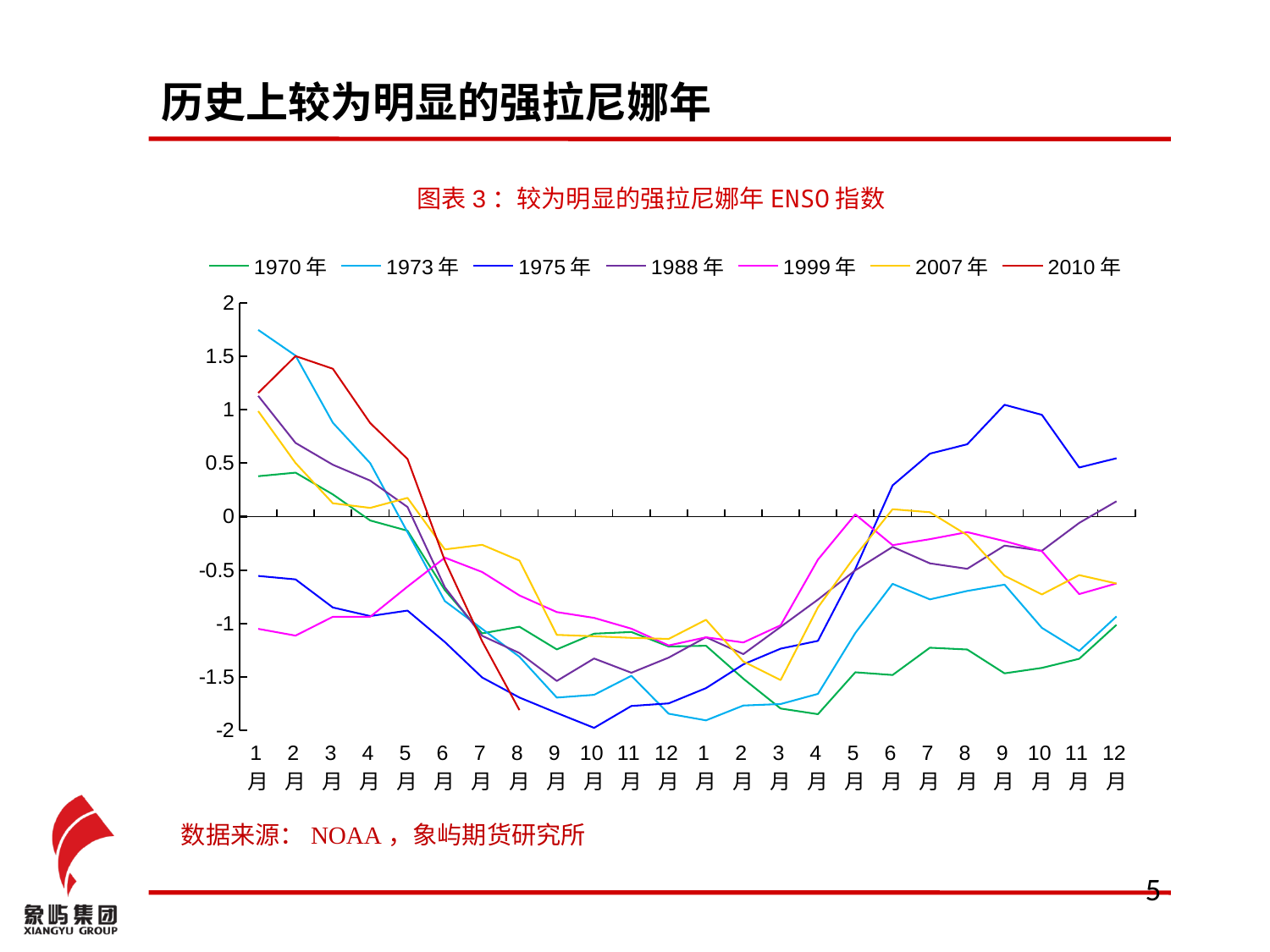
Is the value for 2010年 at 8月 greater or less than -1.5? less At the first 1月, which series has the higher value, 1973年 or 1975年? 1973年 What is the title of the chart? 图表 3：较为明显的强拉尼娜年 ENSO 指数 How many monthly points are shown along the x axis? 24 Does the 2010年 line rise or fall from 2月 to 8月? fall Which series has the highest value at the first 1月? 1973年 What kind of chart is shown on the slide? line chart Is the value for 1975年 at the first 1月 greater or less than 0? less Is the value for 1975年 at the second 9月 greater or less than 0.5? greater How many series does the legend list? 7